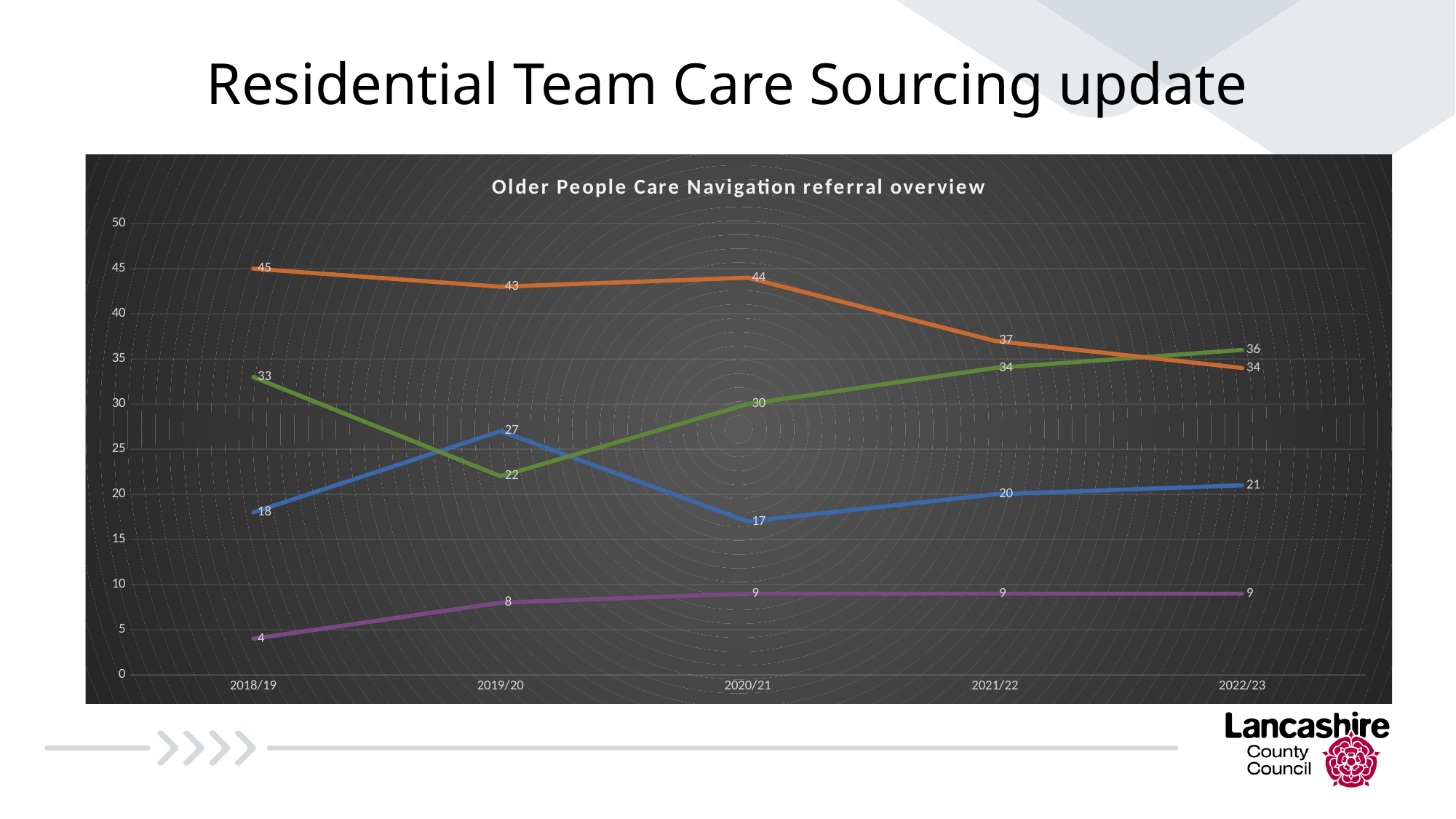
In 2022/23, which is larger: the green line's value or the orange line's value? green line In which period does the orange line reach its highest value? 2018/19 What is the value of the blue line in 2020/21? 17 What is the value of the purple line in 2018/19? 4 What is the difference between the orange line's value in 2018/19 and its value in 2022/23? 11 How many time periods are shown on the x axis? 5 What is the value of the orange line in 2018/19? 45 How many lines are plotted on the chart? 4 What kind of chart is shown on the slide? line chart In which period is the green line at its lowest value? 2019/20 What is the value of the green line in 2019/20? 22 What is the title of the chart? Older People Care Navigation referral overview